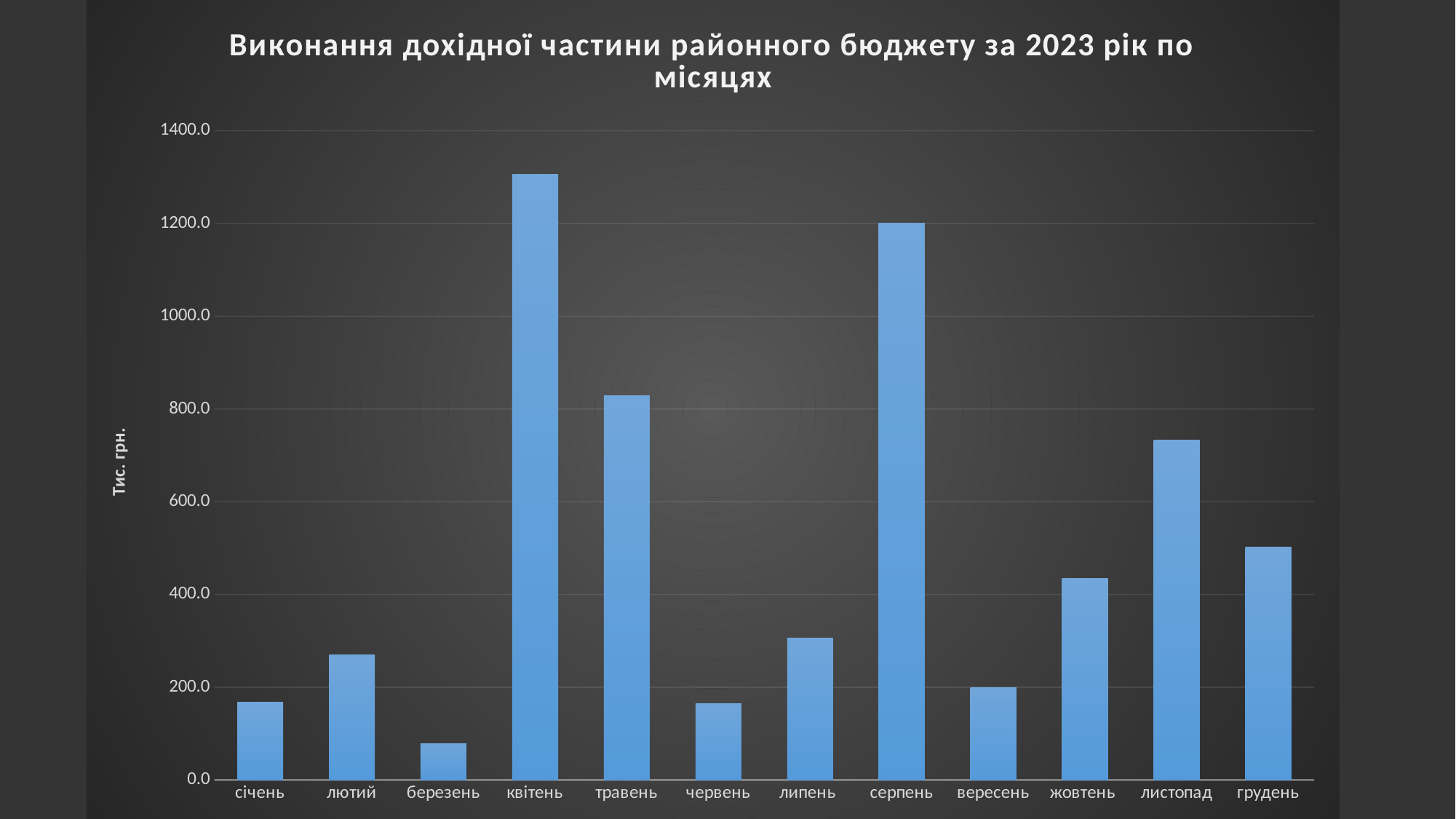
Which is larger, the value for квітень or the value for серпень? квітень Do the values rise or fall from квітень to червень? fall Is the value for липень greater or less than 400.0? less What kind of chart is shown on the slide? bar chart Is the value for березень greater or less than 200.0? less How many months (categories) are shown on the x axis? 12 Which month has the highest value? квітень Is the value for жовтень greater or less than 400.0? greater Which month has the lowest value? березень Which is larger, the value for травень or the value for листопад? травень What is the label on the vertical axis? Тис. грн.